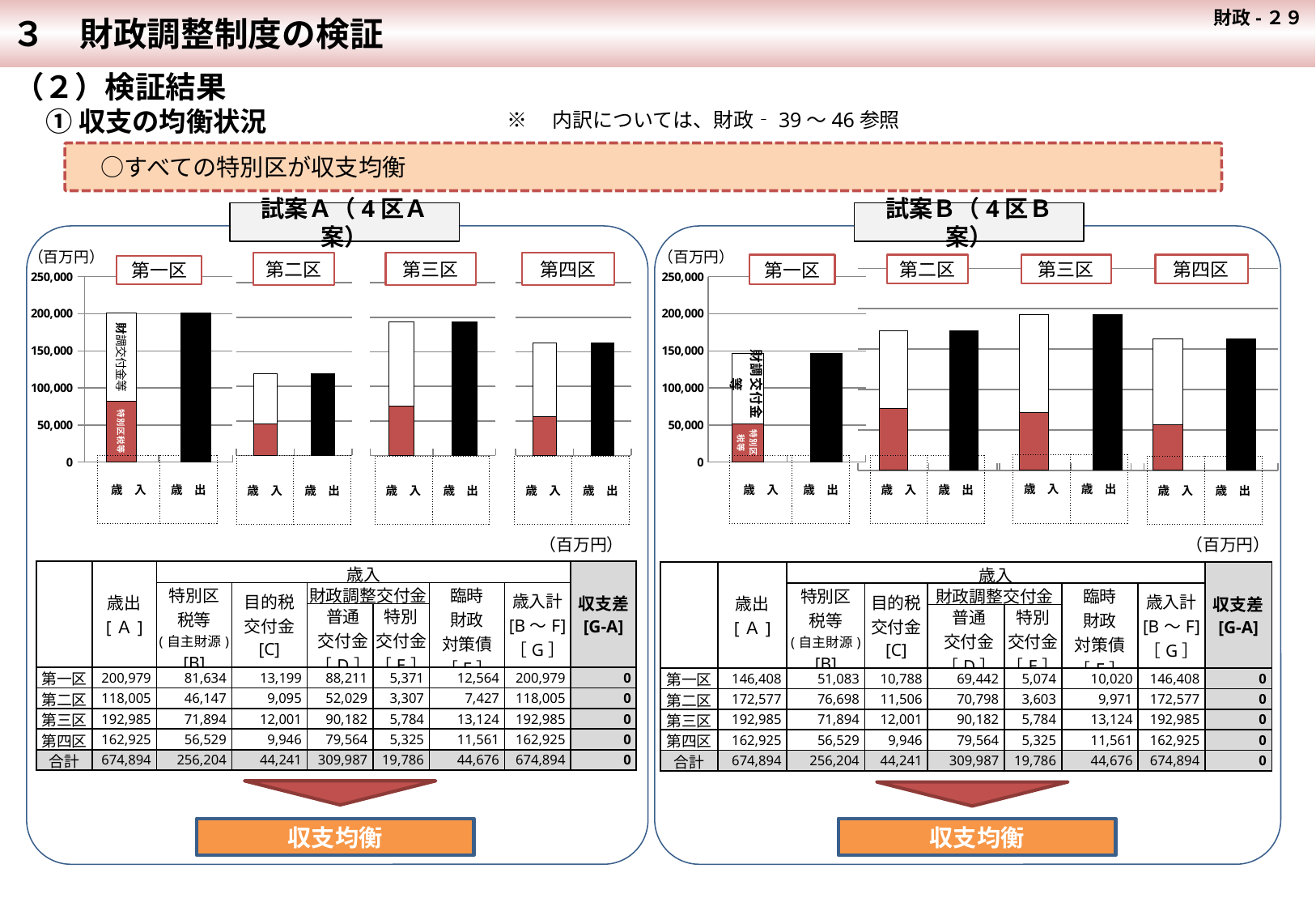
In the 試案A（4区A案） chart on the left, which is larger, the 歳出 for 第一区 or the 歳出 for 第二区? 第一区 In the 試案A（4区A案） chart on the left, how many 特別区 (districts) are shown? 4 What kind of chart is used in the 試案A（4区A案） panel on the left? bar chart In the 試案A（4区A案） chart on the left, which district has the lowest 歳出 bar? 第二区 In the 試案A（4区A案） chart on the left, is the 特別区税等 (red) portion of 歳入 for 第一区 greater or less than 50,000? greater In the 試案A（4区A案） chart on the left, is the 歳出 value for 第一区 greater or less than 150,000? greater In the 試案B（4区B案） chart on the right, which district has the highest 歳出 bar? 第三区 In the 試案B（4区B案） chart on the right, which is larger, the 歳出 for 第一区 or the 歳出 for 第二区? 第二区 In the 試案B（4区B案） chart on the right, is the 歳出 value for 第二区 greater or less than 150,000? greater In the 試案A（4区A案） chart on the left, what unit is shown for the vertical axis? 百万円 In the 試案B（4区B案） chart on the right, which district has the lowest 歳出 bar? 第一区